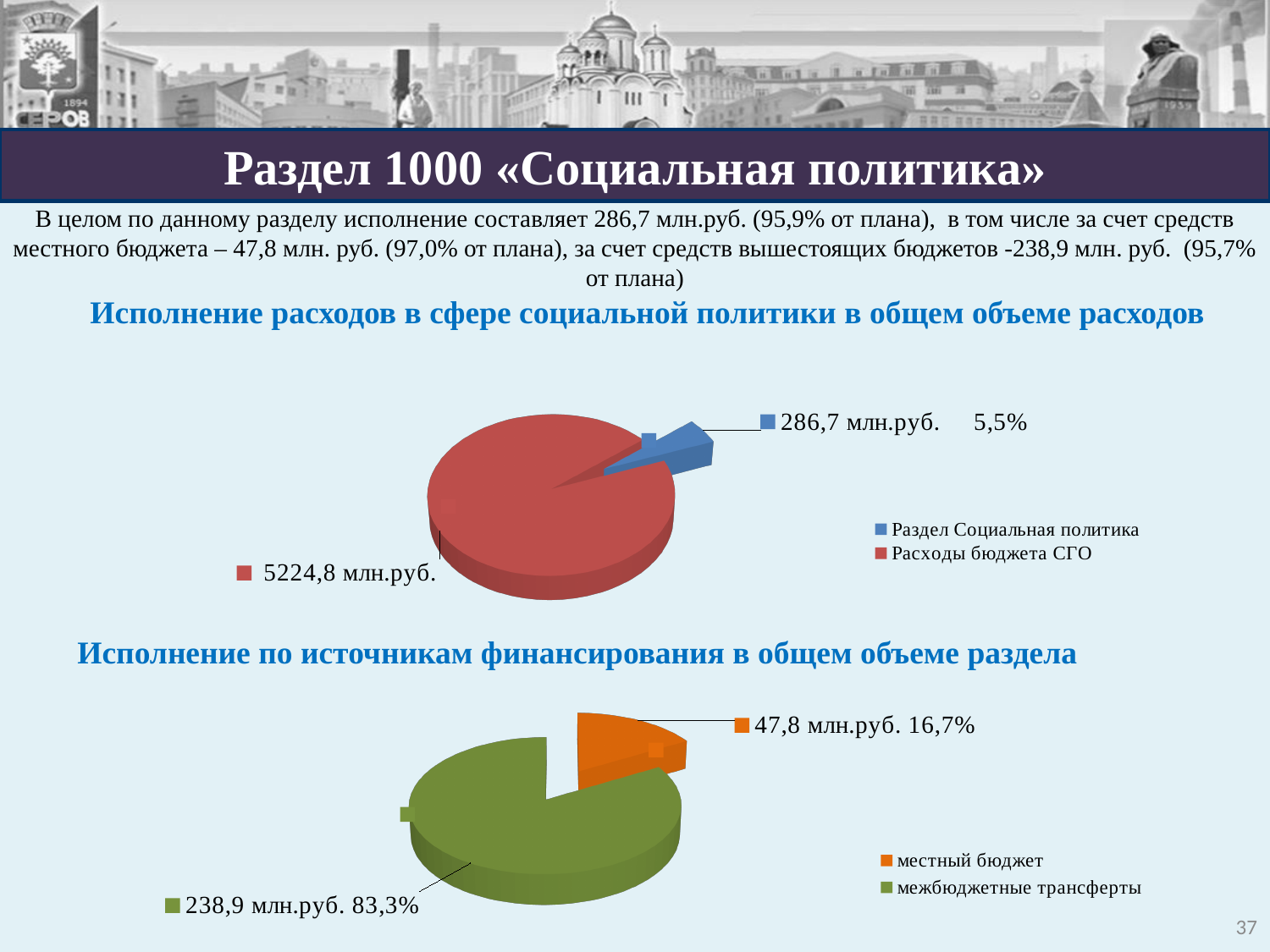
On the top chart 'Исполнение расходов в сфере социальной политики в общем объеме расходов', what value is shown for 'Расходы бюджета СГО'? 5224,8 млн.руб. On the bottom chart 'Исполнение по источникам финансирования в общем объеме раздела', what value is shown for 'местный бюджет'? 47,8 млн.руб. On the bottom chart 'Исполнение по источникам финансирования в общем объеме раздела', what value is shown for 'межбюджетные трансферты'? 238,9 млн.руб. On the top chart 'Исполнение расходов в сфере социальной политики в общем объеме расходов', what share of the pie does 'Раздел Социальная политика' take? 5,5% What kind of chart is the top chart 'Исполнение расходов в сфере социальной политики в общем объеме расходов'? Pie chart On the top chart 'Исполнение расходов в сфере социальной политики в общем объеме расходов', what value is shown for 'Раздел Социальная политика'? 286,7 млн.руб. How many entries does the legend of the top chart 'Исполнение расходов в сфере социальной политики в общем объеме расходов' list? 2 On the bottom chart 'Исполнение по источникам финансирования в общем объеме раздела', what is the difference between 'межбюджетные трансферты' and 'местный бюджет'? 191,1 млн.руб. On the top chart 'Исполнение расходов в сфере социальной политики в общем объеме расходов', which slice is the largest? Расходы бюджета СГО On the bottom chart 'Исполнение по источникам финансирования в общем объеме раздела', which slice is the smallest? местный бюджет On the bottom chart 'Исполнение по источникам финансирования в общем объеме раздела', what share of the pie does 'межбюджетные трансферты' take? 83,3% On the bottom chart 'Исполнение по источникам финансирования в общем объеме раздела', what colour is the 'местный бюджет' slice? Orange